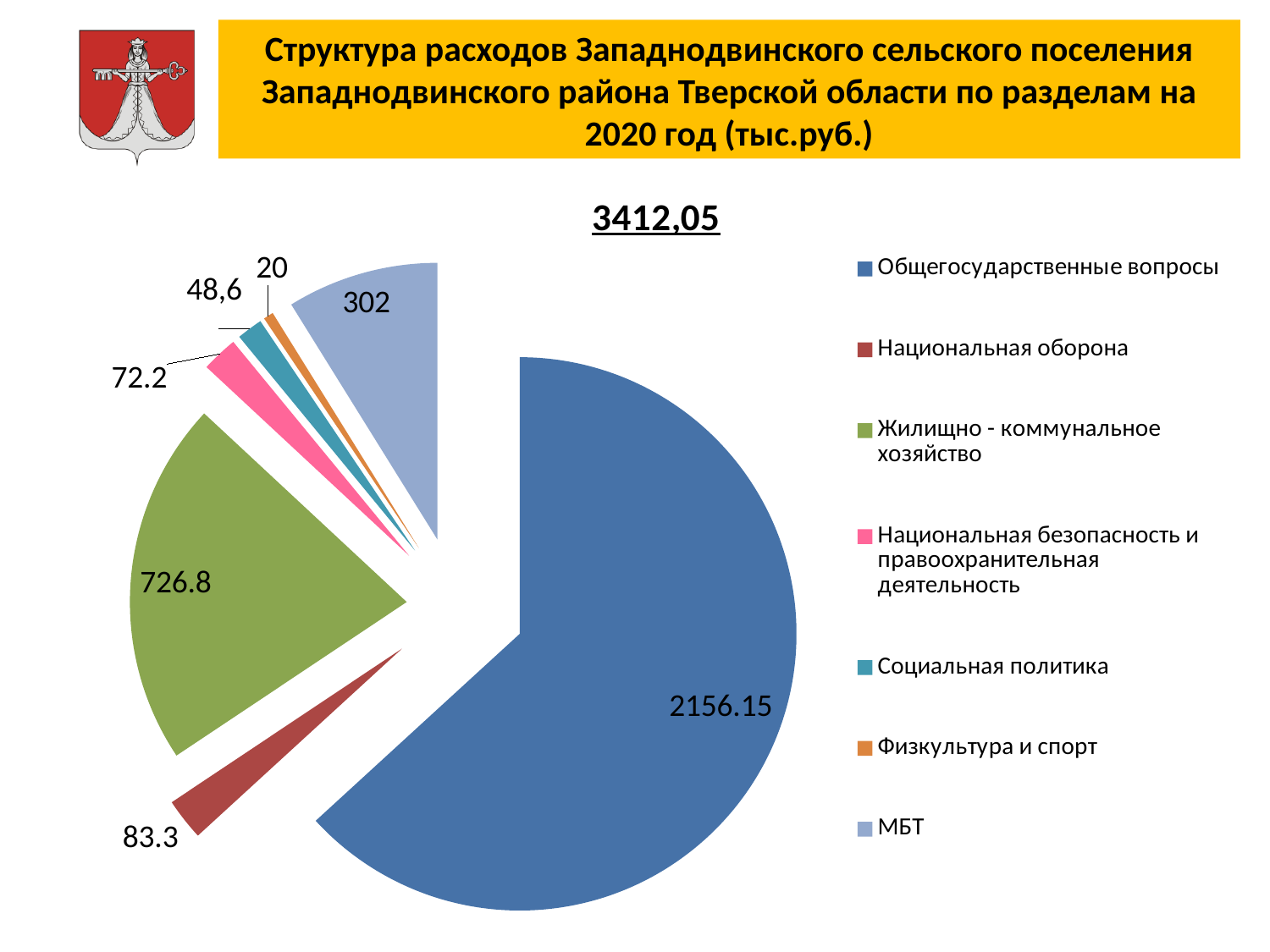
How many categories does the legend list? 7 What is the value for Жилищно - коммунальное хозяйство? 726.8 Which category has the smallest slice of the pie? Физкультура и спорт What is the value for Национальная оборона? 83.3 What total value is printed above the pie chart? 3412,05 What is the value for Социальная политика? 48,6 Which is larger: the value for Национальная оборона or the value for Национальная безопасность и правоохранительная деятельность? Национальная оборона What is the value for Общегосударственные вопросы? 2156.15 Which category has the largest slice of the pie? Общегосударственные вопросы What type of chart is shown on the slide? pie chart What is the value for МБТ? 302 What is the difference between the values for Жилищно - коммунальное хозяйство and МБТ? 424.8